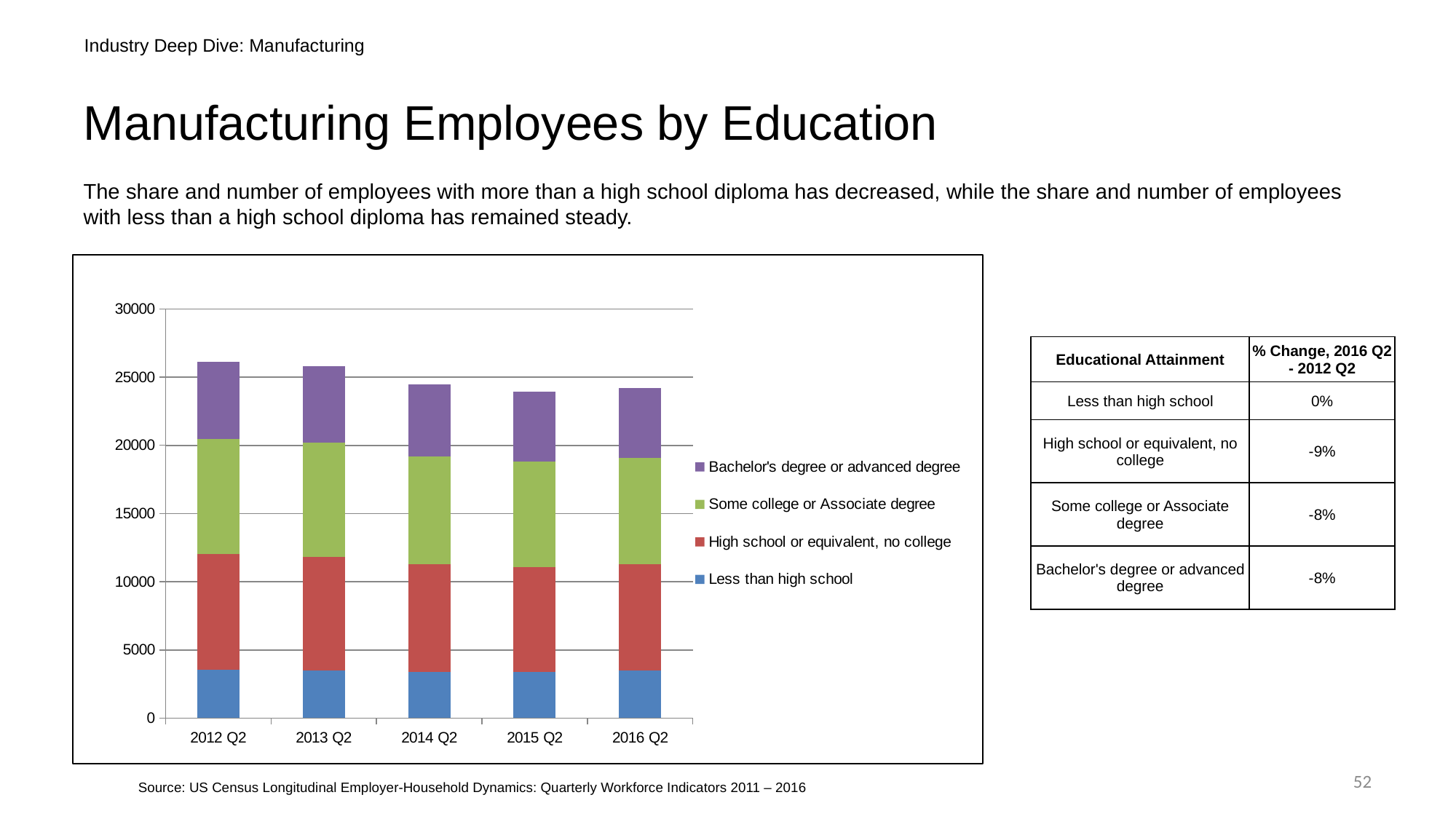
Which stacked bar is taller, 2012 Q2 or 2015 Q2? 2012 Q2 How many series does the chart's legend list? 4 Is the top of the 'High school or equivalent, no college' segment for 2012 Q2 above or below 10000? above What colour represents 'Bachelor's degree or advanced degree' in the chart? Purple Is the total stacked bar for 2015 Q2 greater or less than 25000? less Is the total stacked bar for 2012 Q2 greater or less than 25000? greater Which series is shown at the bottom of each stacked bar? Less than high school What kind of chart is shown on the slide? Stacked bar chart Which quarter has the tallest stacked bar (highest total employees)? 2012 Q2 Do the total stacked bar heights generally rise or fall from 2012 Q2 to 2016 Q2? Fall How many quarters (categories) are plotted on the x axis of the chart? 5